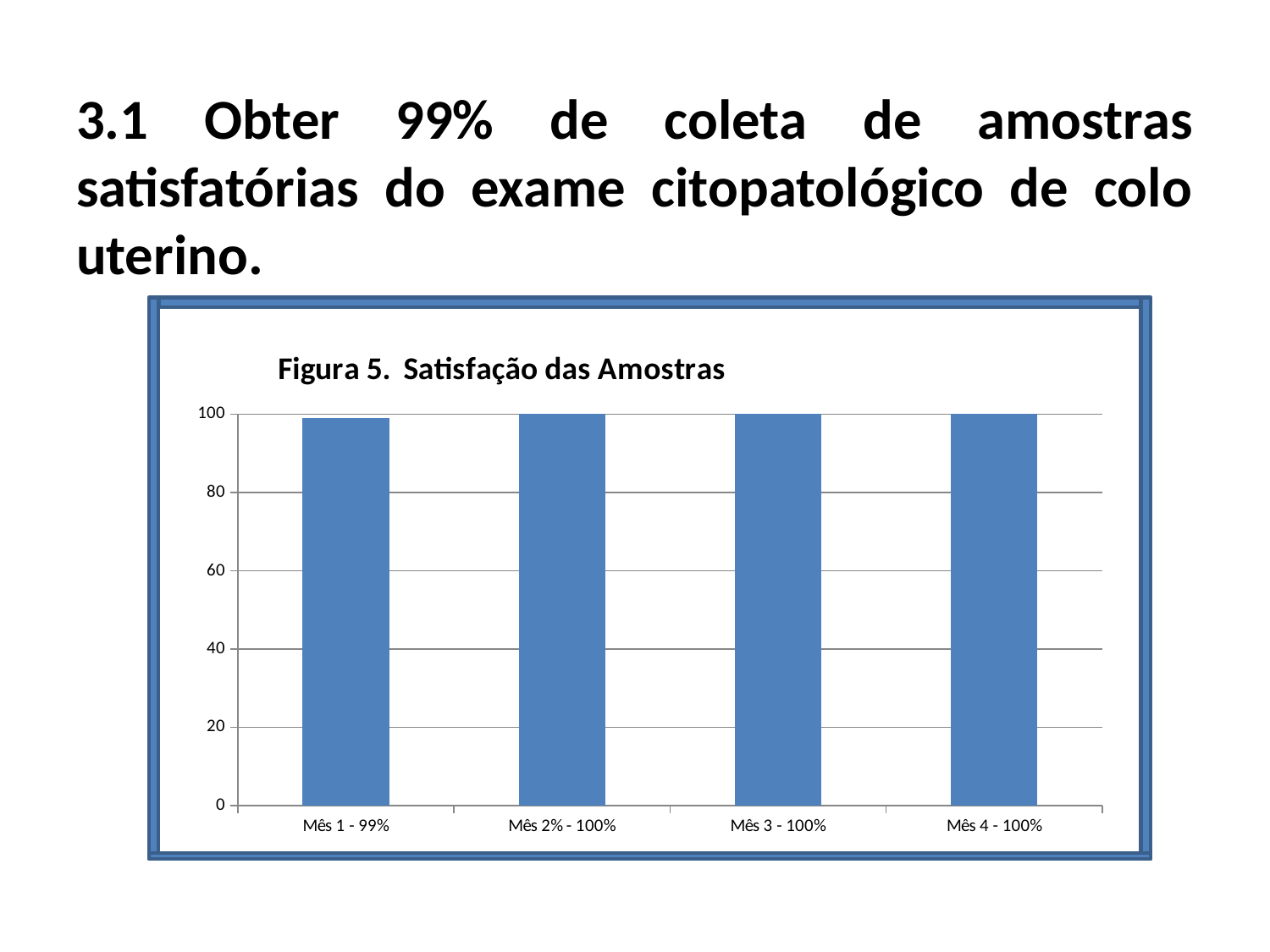
Which is larger, the value for Mês 1 or the value for Mês 4? Mês 4 What is the highest value shown on the vertical axis? 100 How many bars (categories) does the chart show? 4 What value is given for Mês 3 in its category label? 100% What is the difference between the value for Mês 2 and the value for Mês 1? 1% What value is given for Mês 1 in its category label? 99% Which category has the lowest value? Mês 1 - 99% Is the value for Mês 1 greater or less than 60? greater What kind of chart is shown on the slide? Bar chart Is the value for Mês 3 greater or less than 80? greater What is the title of the chart? Figura 5. Satisfação das Amostras What value is given for Mês 4 in its category label? 100%